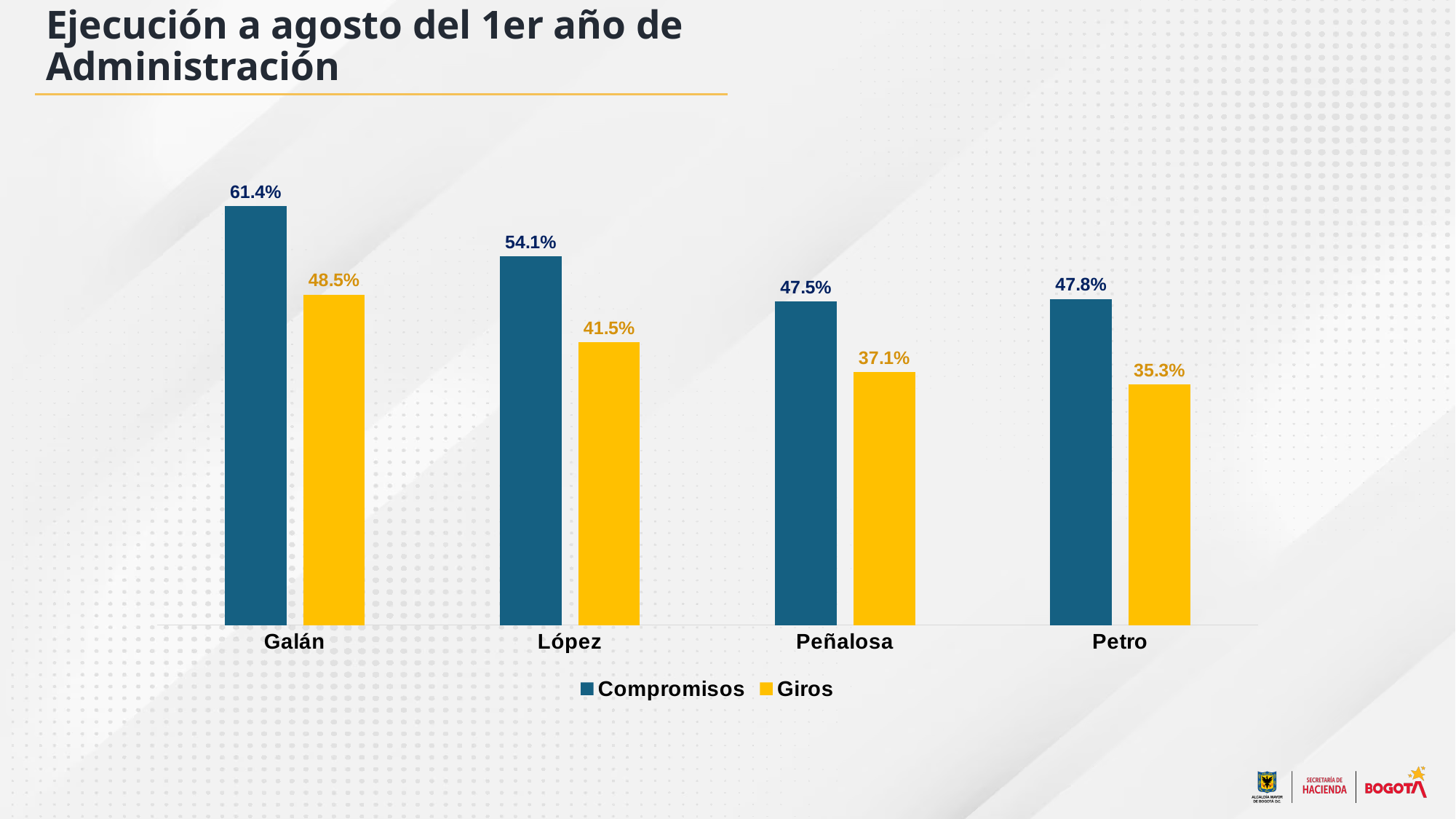
How many series does the legend list? 2 What is the Compromisos value for Galán? 61.4% Which category has the lowest Giros value? Petro Which category has the highest Compromisos value? Galán Which is larger: the Giros value for Galán or the Compromisos value for Peñalosa? Giros value for Galán What is the Compromisos value for López? 54.1% What kind of chart is shown on the slide? Bar chart What is the difference between the Compromisos and Giros values for Galán? 12.9% What is the Giros value for Petro? 35.3% What is the difference between the Giros values for López and Peñalosa? 4.4% How many categories are shown on the x axis? 4 What is the Giros value for Peñalosa? 37.1%